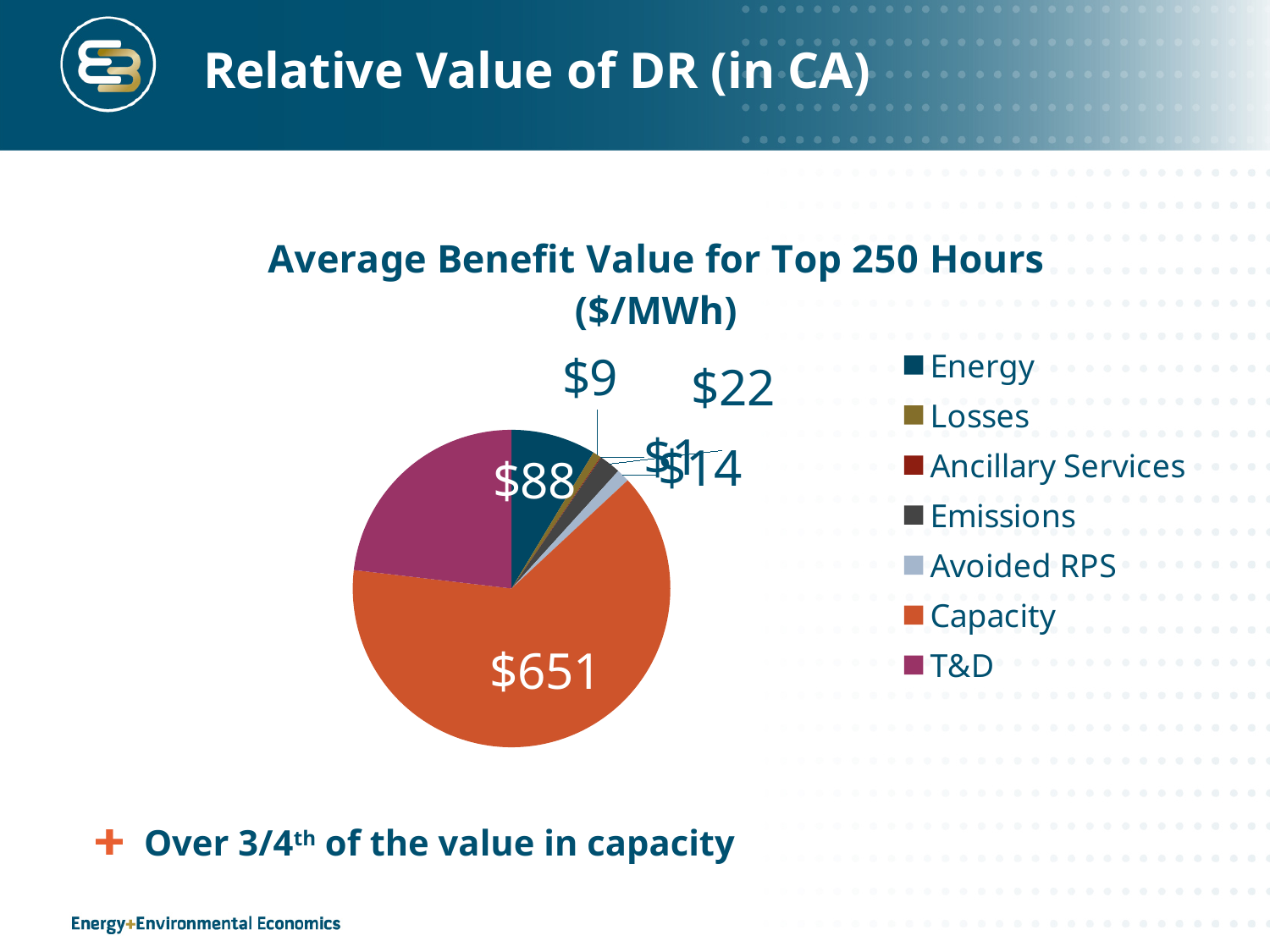
How many categories does the legend of the pie chart list? 7 What colour is used for the Capacity slice in the pie chart? orange What kind of chart is shown on the slide? pie chart Which category has the largest slice of the pie chart? Capacity What is the title of the chart? Average Benefit Value for Top 250 Hours ($/MWh) What is the value shown for Energy in the pie chart? $88 What is the value shown for Capacity in the pie chart? $651 Which is larger, the T&D slice or the Energy slice? T&D What is the difference between the Capacity value and the Energy value? $563 Which is larger, the Capacity slice or the Energy slice? Capacity Which category has the second largest slice of the pie chart? T&D